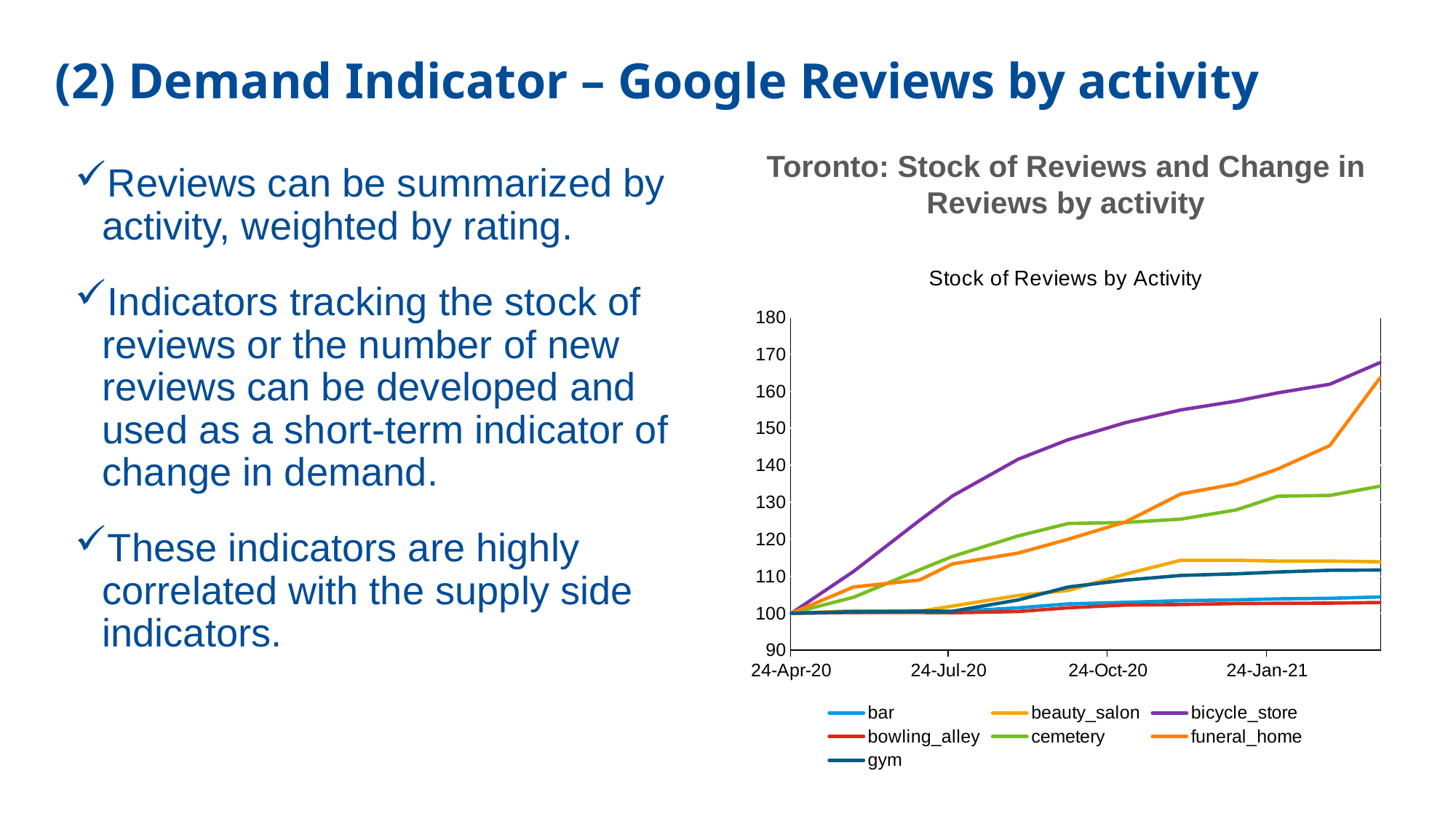
What kind of chart is shown on the slide? line chart Is the value for bicycle_store at the end of the period greater or less than 160? greater What is the title shown above the chart area on the right of the slide? Toronto: Stock of Reviews and Change in Reviews by activity Is the value for cemetery at the end of the period greater or less than 130? greater What value do all the series start at on 24-Apr-20? 100 At 24-Jan-21, which is higher: bicycle_store or cemetery? bicycle_store Is the value for bar at the end of the period greater or less than 110? less At the end of the period, which is higher: funeral_home or cemetery? funeral_home Which activity has the lowest stock of reviews at the end of the period shown? bowling_alley How many series does the legend of the Stock of Reviews by Activity chart list? 7 Which activity has the highest stock of reviews at the end of the period shown? bicycle_store Does the bicycle_store line rise or fall over the period shown? rise